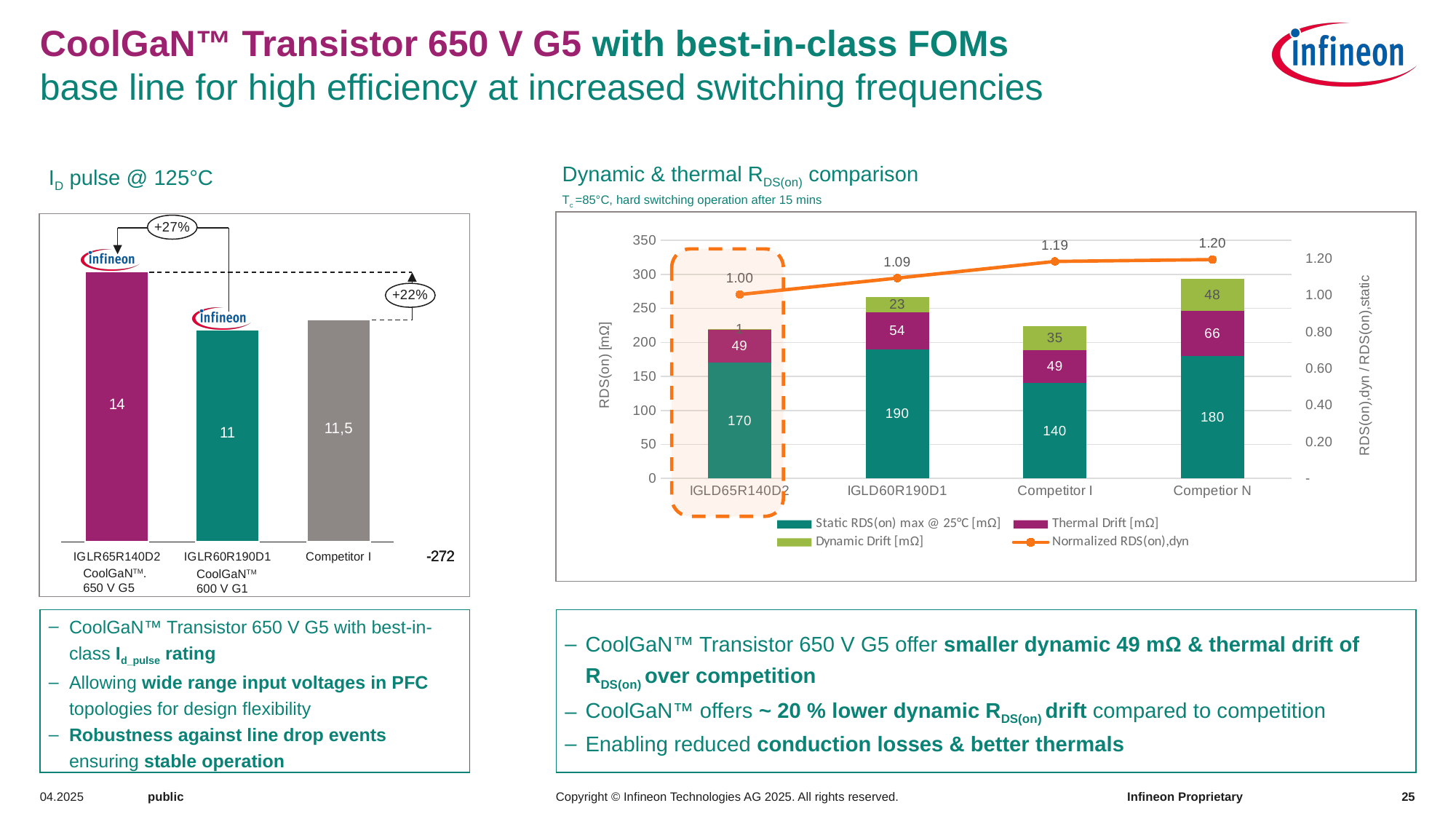
In the 'Dynamic & thermal RDS(on) comparison' chart, how many series does the legend list? 4 In the 'Dynamic & thermal RDS(on) comparison' chart, which category has the highest Dynamic Drift value? Competior N In the 'Dynamic & thermal RDS(on) comparison' chart, what is the Normalized RDS(on),dyn value for IGLD60R190D1? 1.09 In the 'ID pulse @ 125°C' chart, what is the difference between the values for IGLR65R140D2 and IGLR60R190D1? 3 In the 'Dynamic & thermal RDS(on) comparison' chart, which is larger: the Thermal Drift for IGLD60R190D1 or for Competitor I? IGLD60R190D1 In the 'ID pulse @ 125°C' chart, which category has the lowest value? IGLR60R190D1 In the 'ID pulse @ 125°C' chart, how many bars are plotted? 3 In the 'ID pulse @ 125°C' chart, what is the value for IGLR65R140D2? 14 In the 'Dynamic & thermal RDS(on) comparison' chart, what is the Thermal Drift value for Competior N? 66 In the 'Dynamic & thermal RDS(on) comparison' chart, does the Normalized RDS(on),dyn line rise or fall from left to right? rise In the 'Dynamic & thermal RDS(on) comparison' chart, what is the total stacked value for Competitor I? 224 In the 'Dynamic & thermal RDS(on) comparison' chart, what is the Static RDS(on) max @ 25°C value for Competitor I? 140